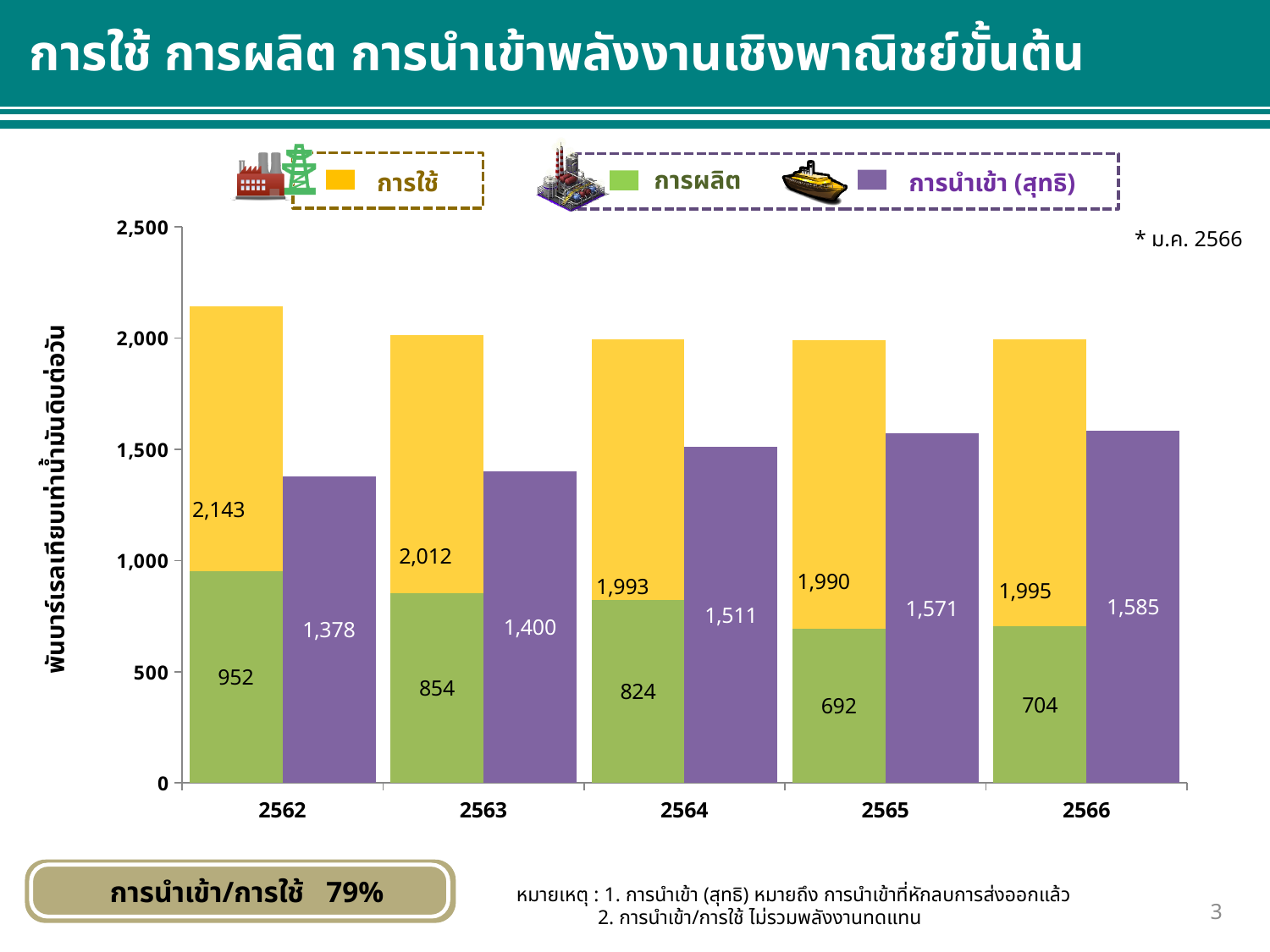
Which is larger, การผลิต in 2563 or การผลิต in 2564? การผลิต in 2563 Does การนำเข้า (สุทธิ) rise or fall from 2562 to 2566? rise What is the difference between การนำเข้า (สุทธิ) in 2566 and in 2562? 207 What is the value of การนำเข้า (สุทธิ) for 2566? 1,585 What is the value of การใช้ for 2562? 2,143 How many years are shown on the x axis? 5 What kind of chart is shown on the slide? bar chart Is the value of การนำเข้า (สุทธิ) for 2565 greater or less than 1,500? greater Which year has the highest value for การใช้? 2562 How many series does the legend list? 3 Which year has the lowest value for การผลิต? 2565 What is the value of การผลิต for 2565? 692